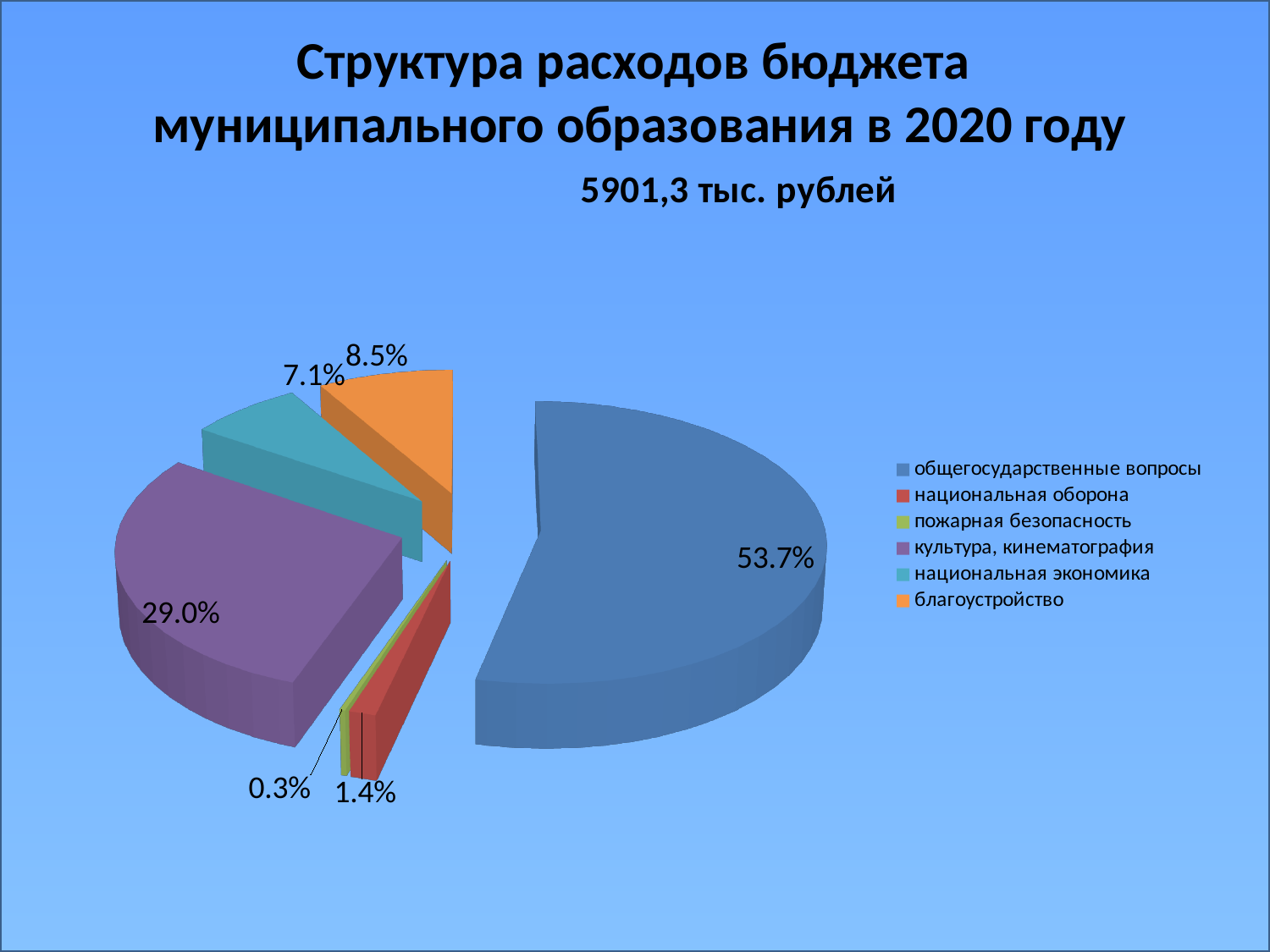
Which category has the largest slice of the pie? общегосударственные вопросы What share of the pie does общегосударственные вопросы have? 53.7% What share of the pie does национальная экономика have? 7.1% How many categories does the legend list? 6 Which is larger: the share of благоустройство or the share of национальная экономика? благоустройство What is the difference between the shares of общегосударственные вопросы and культура, кинематография? 24.7% What share of the pie does благоустройство have? 8.5% What kind of chart is shown on the slide? pie chart Which category has the smallest slice of the pie? пожарная безопасность